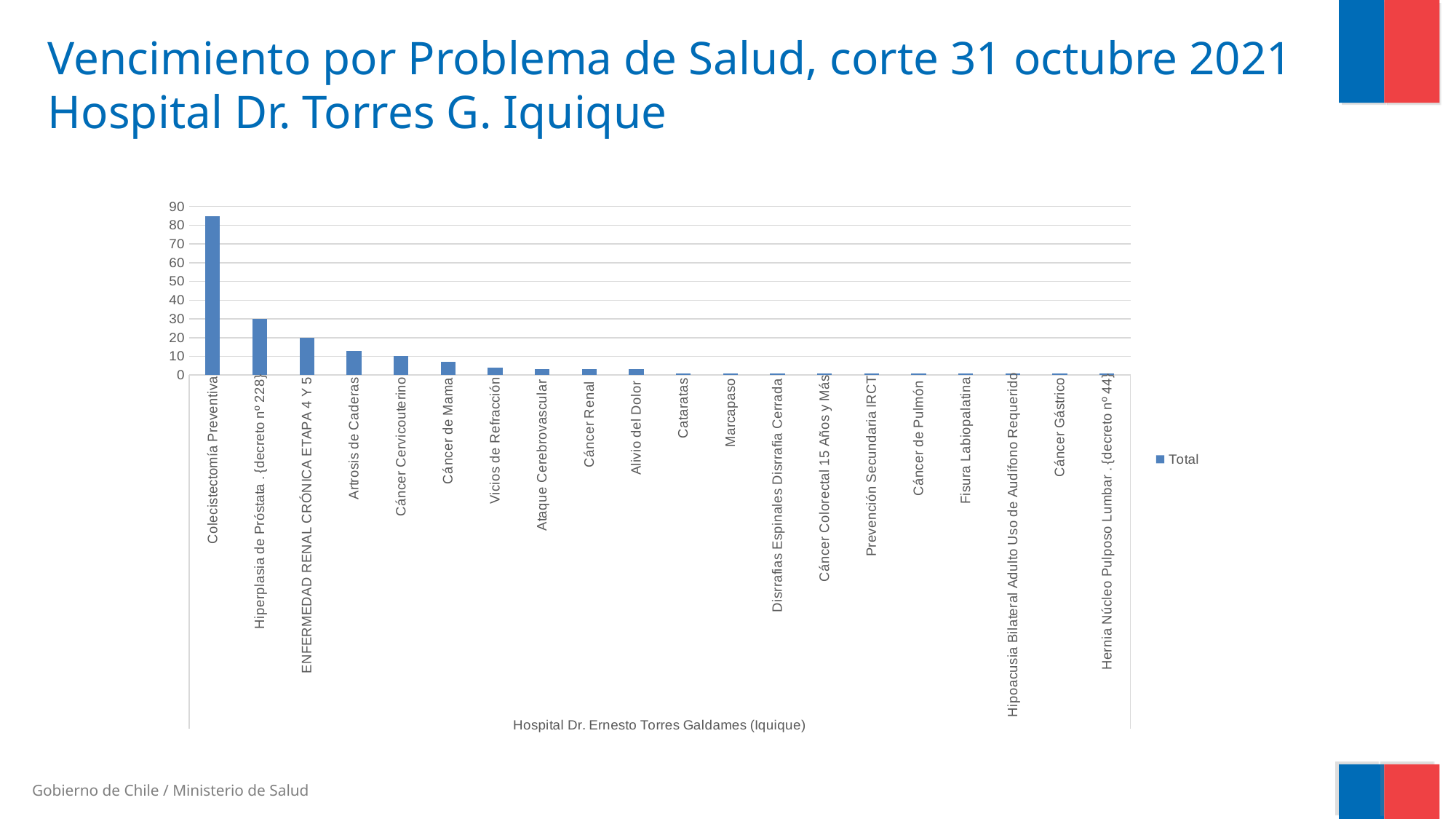
Is the value for Colecistectomía Preventiva greater or less than 80? greater Which health problem has the highest value in the chart? Colecistectomía Preventiva What kind of chart is shown on the slide? bar chart Which is larger, the value for Hiperplasia de Próstata or the value for ENFERMEDAD RENAL CRÓNICA ETAPA 4 Y 5? Hiperplasia de Próstata Is the value for Cáncer de Mama greater or less than 10? less Do the values rise or fall from left to right along the x axis? fall Is the value for Artrosis de Caderas greater or less than 20? less What is the name of the series shown in the legend? Total How many series does the legend list? 1 Which is larger, the value for Cáncer Cervicouterino or the value for Vicios de Refracción? Cáncer Cervicouterino How many health problem categories are shown on the x axis? 20